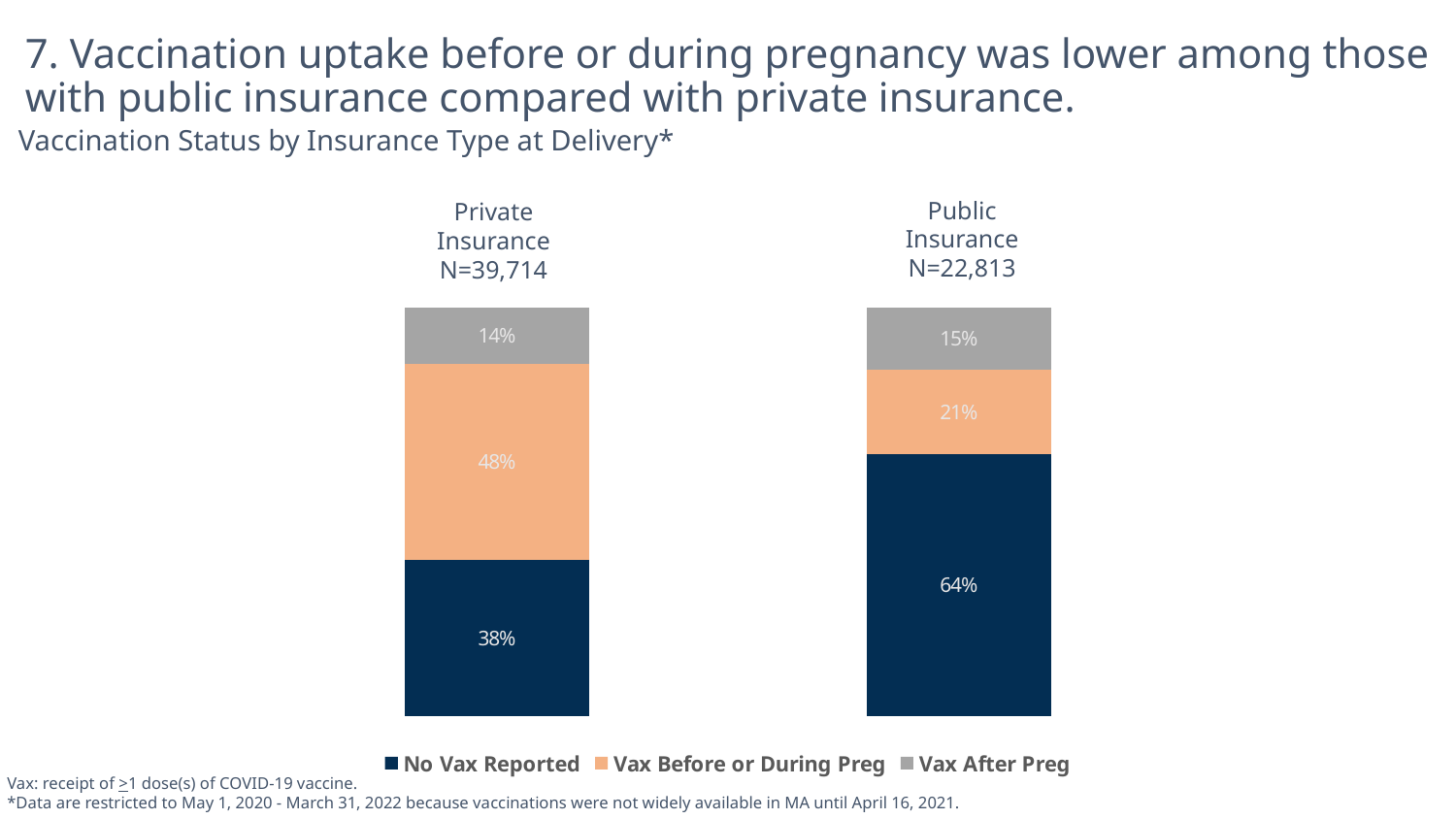
How many insurance categories are shown in the chart? 2 Which legend entry is shown in dark navy blue? No Vax Reported What percentage of those with Public Insurance had No Vax Reported? 64% What percentage of those with Private Insurance were vaccinated after pregnancy? 14% What percentage of those with Public Insurance were vaccinated before or during pregnancy? 21% What is the difference in the Vax Before or During Preg percentage between Private Insurance and Public Insurance? 27 percentage points Which insurance type has the higher share of Vax Before or During Preg? Private Insurance What percentage of those with Private Insurance had No Vax Reported? 38% What is the difference in the No Vax Reported percentage between Public Insurance and Private Insurance? 26 percentage points How many series does the legend list? 3 What is the sample size (N) for the Public Insurance group? N=22,813 What kind of chart is shown on the slide? Stacked bar chart